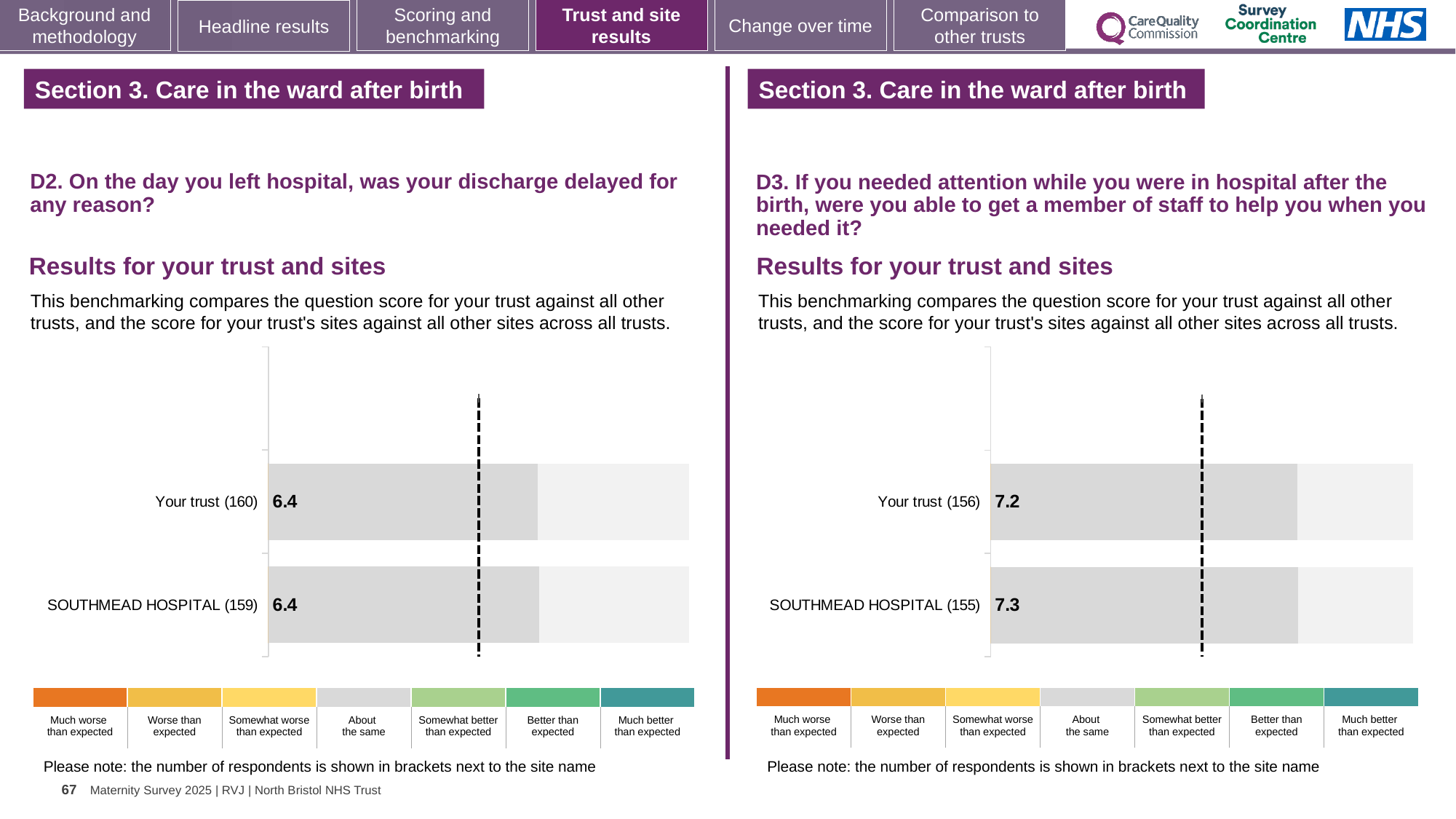
In the D3 chart on the right, what is the difference between the SOUTHMEAD HOSPITAL score and the Your trust score? 0.1 In the D3 chart on the right, which has the higher score, Your trust or SOUTHMEAD HOSPITAL? SOUTHMEAD HOSPITAL In the D3 chart on the right, what is the score for Your trust? 7.2 In the D2 chart on the left, how many respondents are shown in brackets for Your trust? 160 In the D2 chart on the left, what is the score for Your trust? 6.4 In the D3 chart on the right, what is the score for SOUTHMEAD HOSPITAL? 7.3 In the D3 chart on the right, how many respondents are shown in brackets for SOUTHMEAD HOSPITAL? 155 How many bars are shown in the D2 chart on the left? 2 What type of chart is used for the D3 results on the right? Bar chart In the D2 chart on the left, what is the score for SOUTHMEAD HOSPITAL? 6.4 In the D2 chart on the left, what is the difference between the Your trust score and the SOUTHMEAD HOSPITAL score? 0